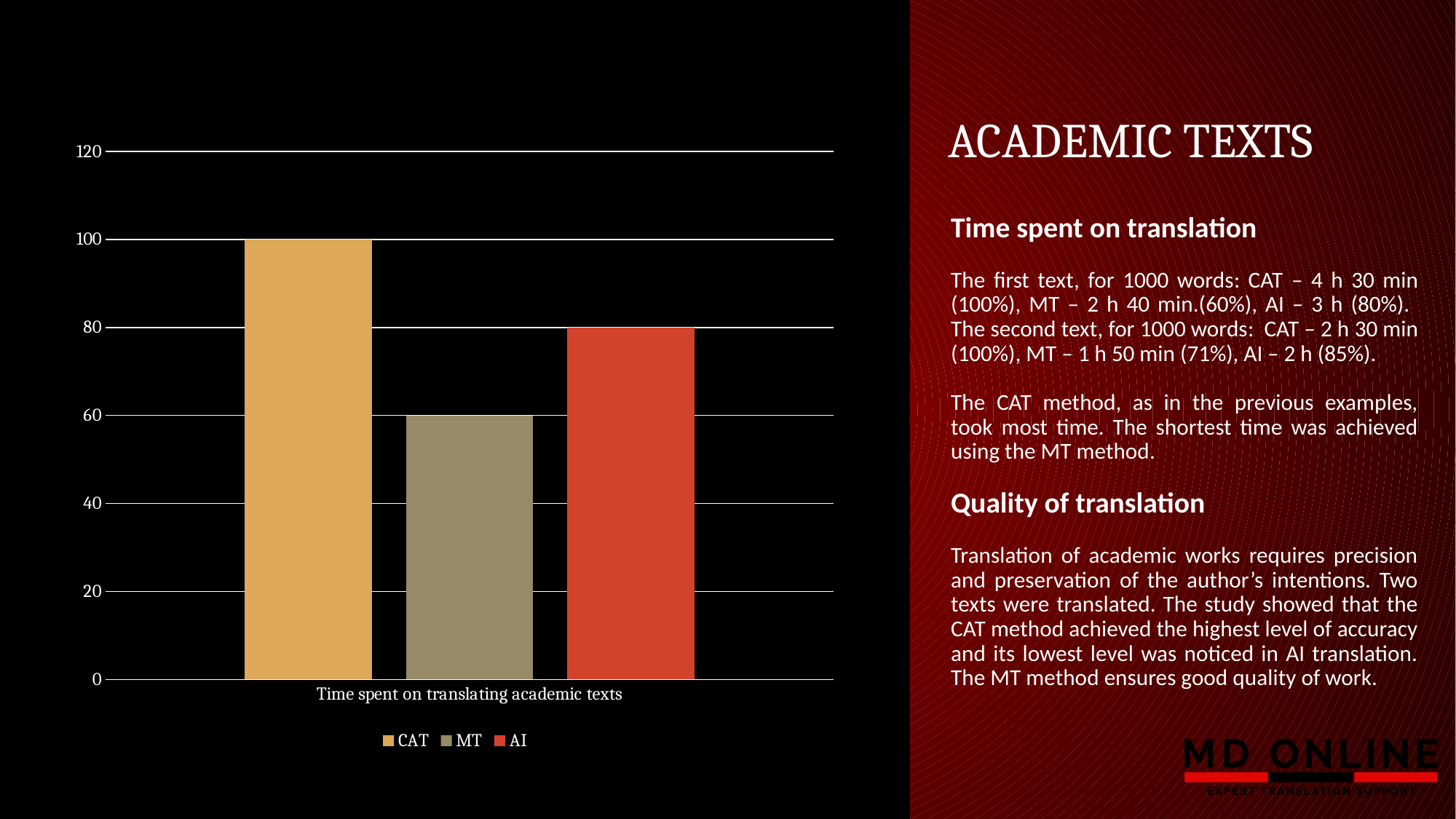
What kind of chart is shown on the slide? bar chart What colour is the AI bar? red What is the value of the MT bar? 60 What is the difference between the CAT bar and the MT bar? 40 Which series has the highest bar? CAT What is the category label shown on the x axis? Time spent on translating academic texts What is the value of the AI bar? 80 Which series has the lowest bar? MT Is the value for AI greater or less than 100? less How many series does the chart legend list? 3 What is the value of the CAT bar? 100 Which is larger, the AI bar or the MT bar? AI